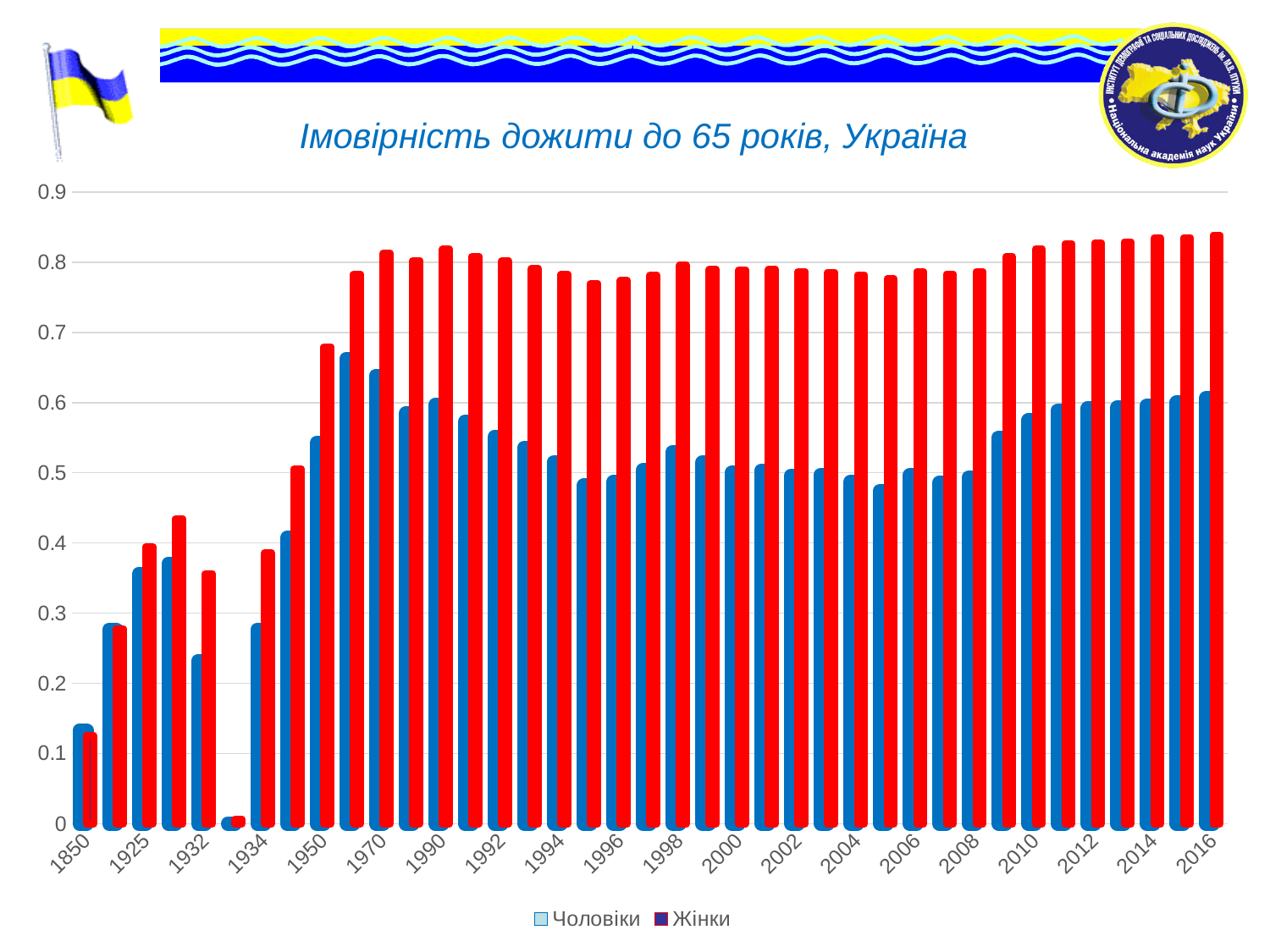
For Чоловіки, which year has the larger value, 1970 or 2000? 1970 What is the title of the chart? Імовірність дожити до 65 років, Україна Is the value for Чоловіки in 1970 greater or less than 0.6? greater Is the value for Жінки in 2016 greater or less than 0.8? greater In 2016, which series has the larger value, Чоловіки or Жінки? Жінки Is the value for Жінки in 1932 greater or less than 0.4? less How many series does the legend list? 2 Which series is shown in red? Жінки Do the values for Чоловіки rise or fall from 2008 to 2016? rise What kind of chart is shown on the slide? Bar chart